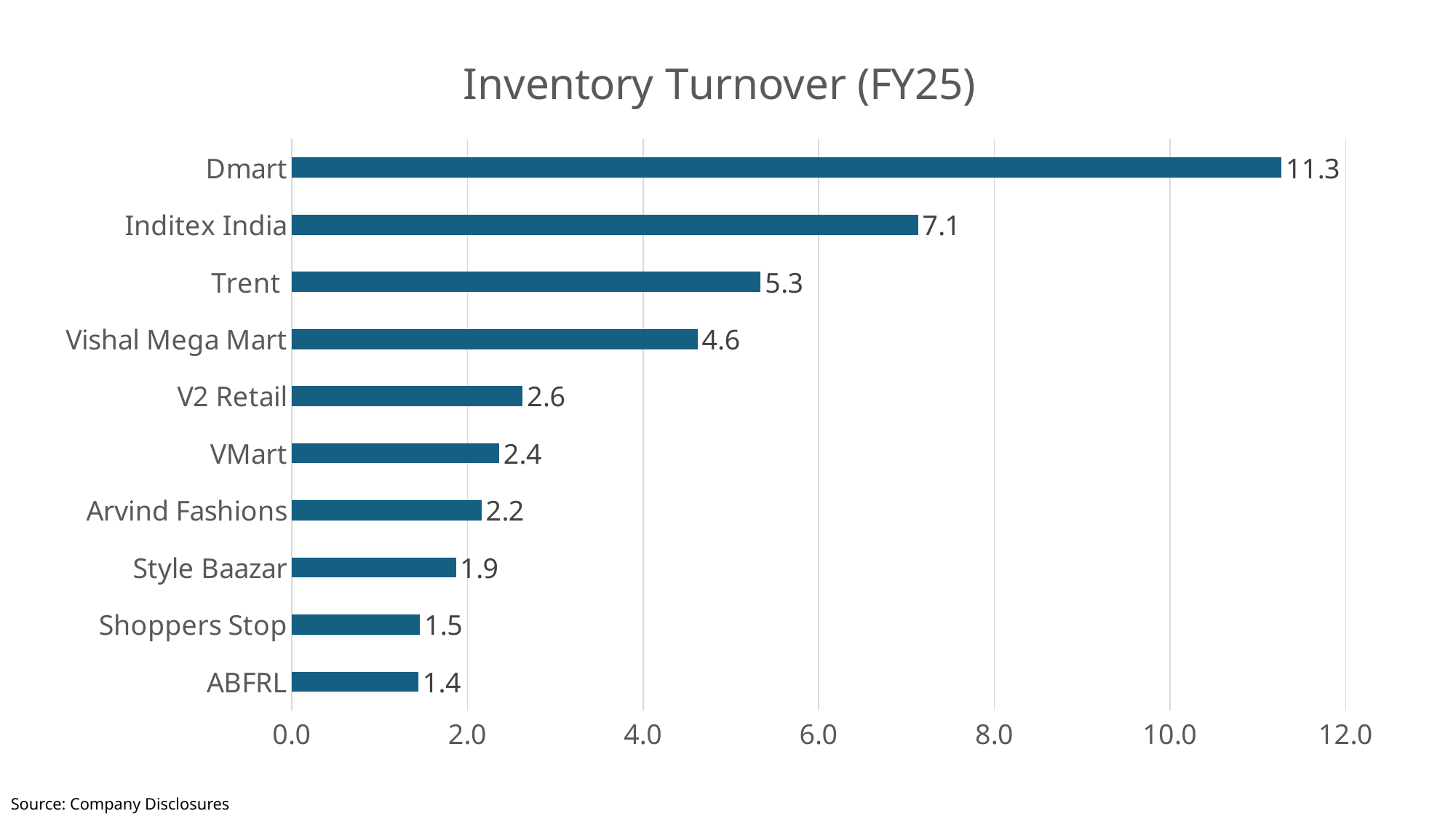
What is the title of the chart? Inventory Turnover (FY25) How many companies are shown in the chart? 10 What is the inventory turnover for Trent? 5.3 What is the inventory turnover for Dmart? 11.3 Which has a higher inventory turnover, Trent or Vishal Mega Mart? Trent Which company has the lowest inventory turnover? ABFRL What is the inventory turnover for Shoppers Stop? 1.5 What is the difference in inventory turnover between Vishal Mega Mart and V2 Retail? 2.0 Is the value for Inditex India greater or less than 6.0? greater Which company has the highest inventory turnover? Dmart What is the difference in inventory turnover between Dmart and Inditex India? 4.2 What kind of chart is shown on the slide? Bar chart